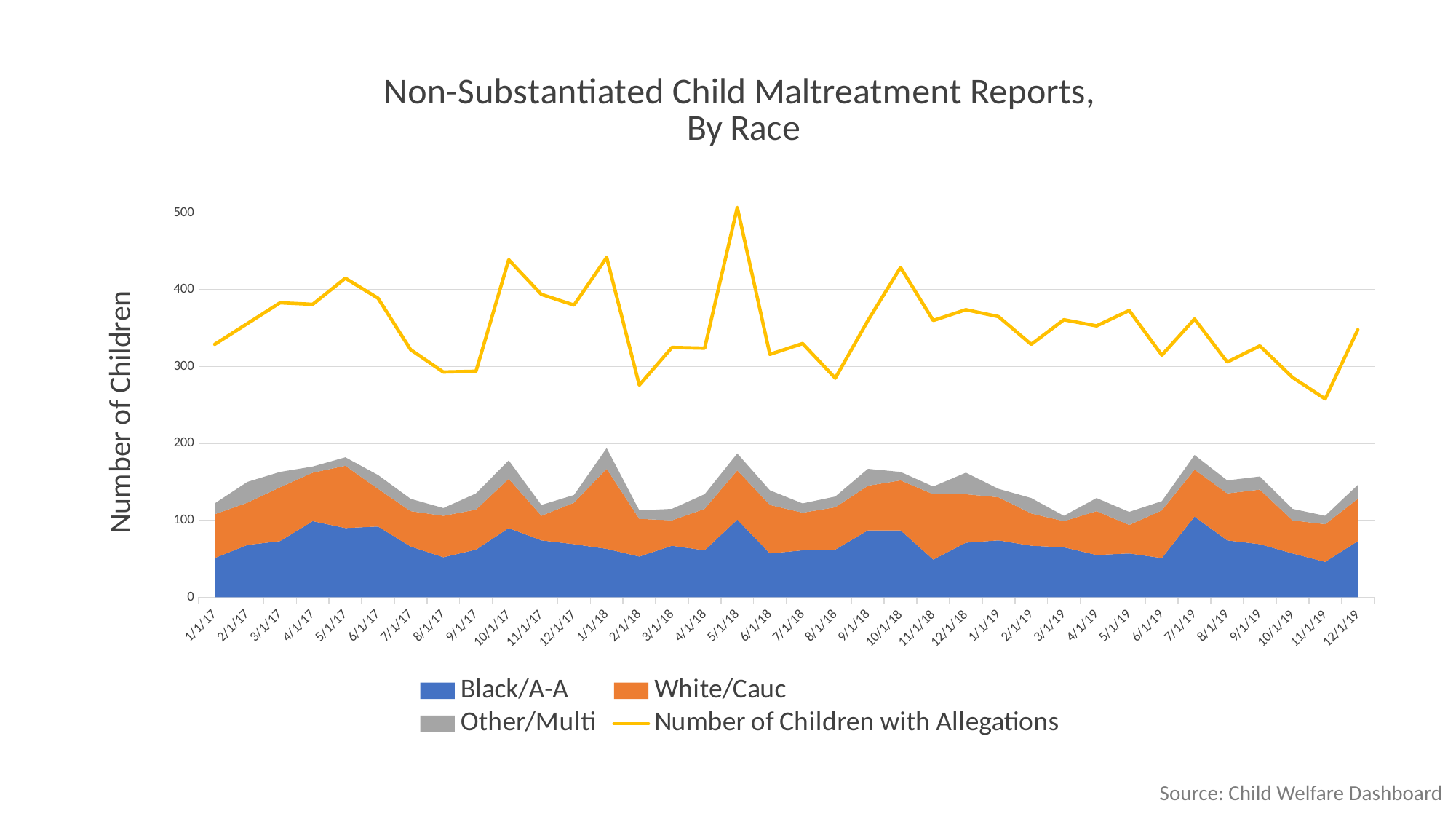
What is the title of the chart? Non-Substantiated Child Maltreatment Reports, By Race At which date does the Number of Children with Allegations line reach its highest value? 5/1/18 At which date does the Number of Children with Allegations line reach its lowest value? 11/1/19 How many series does the legend list? 4 Is the Number of Children with Allegations at 5/1/18 greater or less than 400? greater What kind of chart is this? Stacked area chart with a line Is the Black/A-A value at 8/1/17 greater or less than 100? less Does the Number of Children with Allegations line rise or fall from 9/1/19 to 11/1/19? fall Is the Number of Children with Allegations at 11/1/19 greater or less than 300? less What is the label on the vertical axis? Number of Children How many monthly points are shown on the x axis? 36